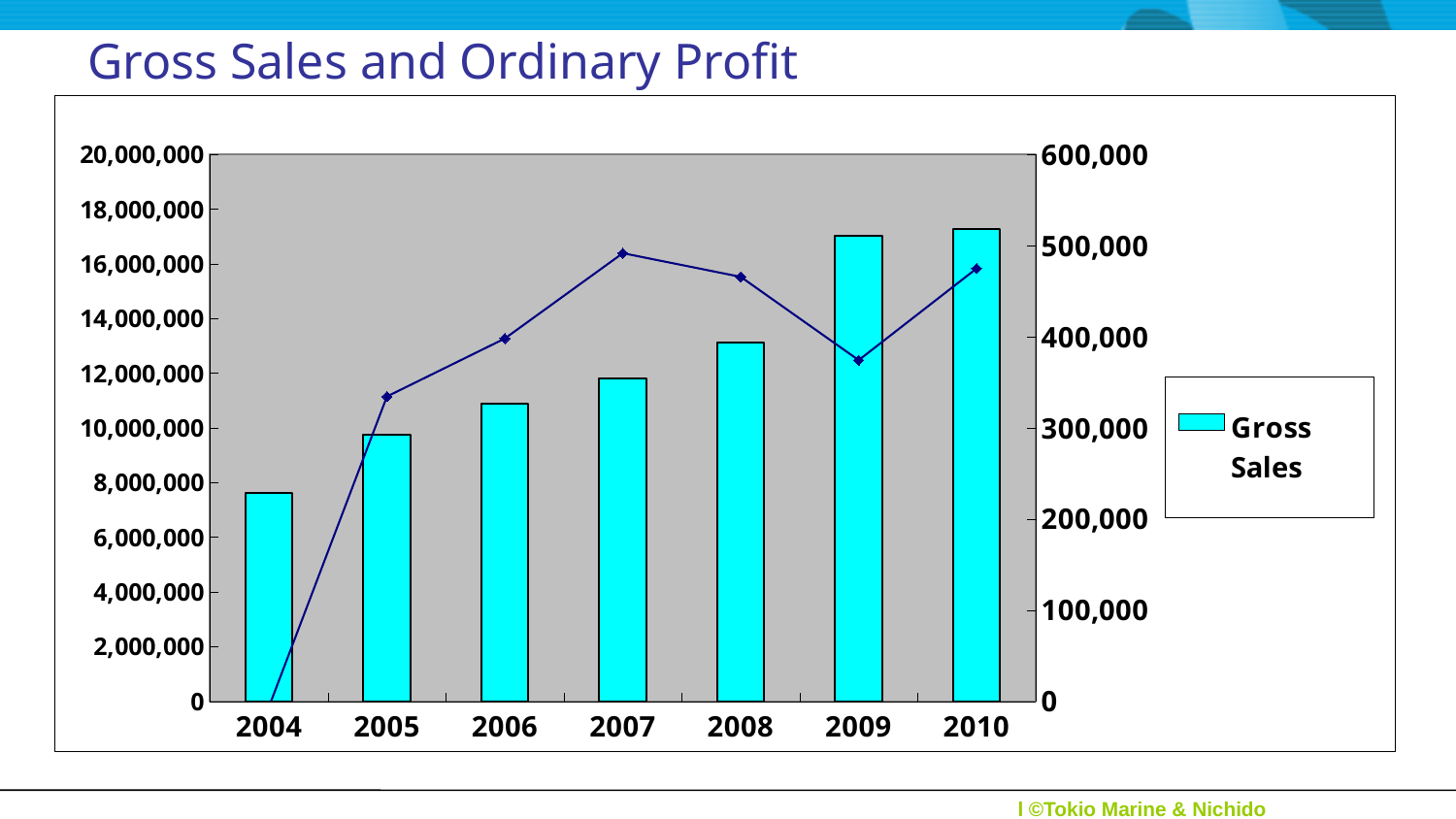
Is the line series value for 2009 (right axis) greater or less than 400,000? less Is the Gross Sales value for 2004 greater or less than 8,000,000? less Is the Gross Sales value for 2009 greater or less than 16,000,000? greater How many series does the chart's legend list? 1 In which year does the line series reach its highest point? 2007 Do the Gross Sales bars generally rise or fall from 2004 to 2010? rise What kind of chart is shown on the slide? bar and line chart Which year has the lowest Gross Sales bar? 2004 How many years are shown on the x axis of the chart? 7 What series name appears in the chart's legend? Gross Sales Which year has higher Gross Sales, 2008 or 2009? 2009